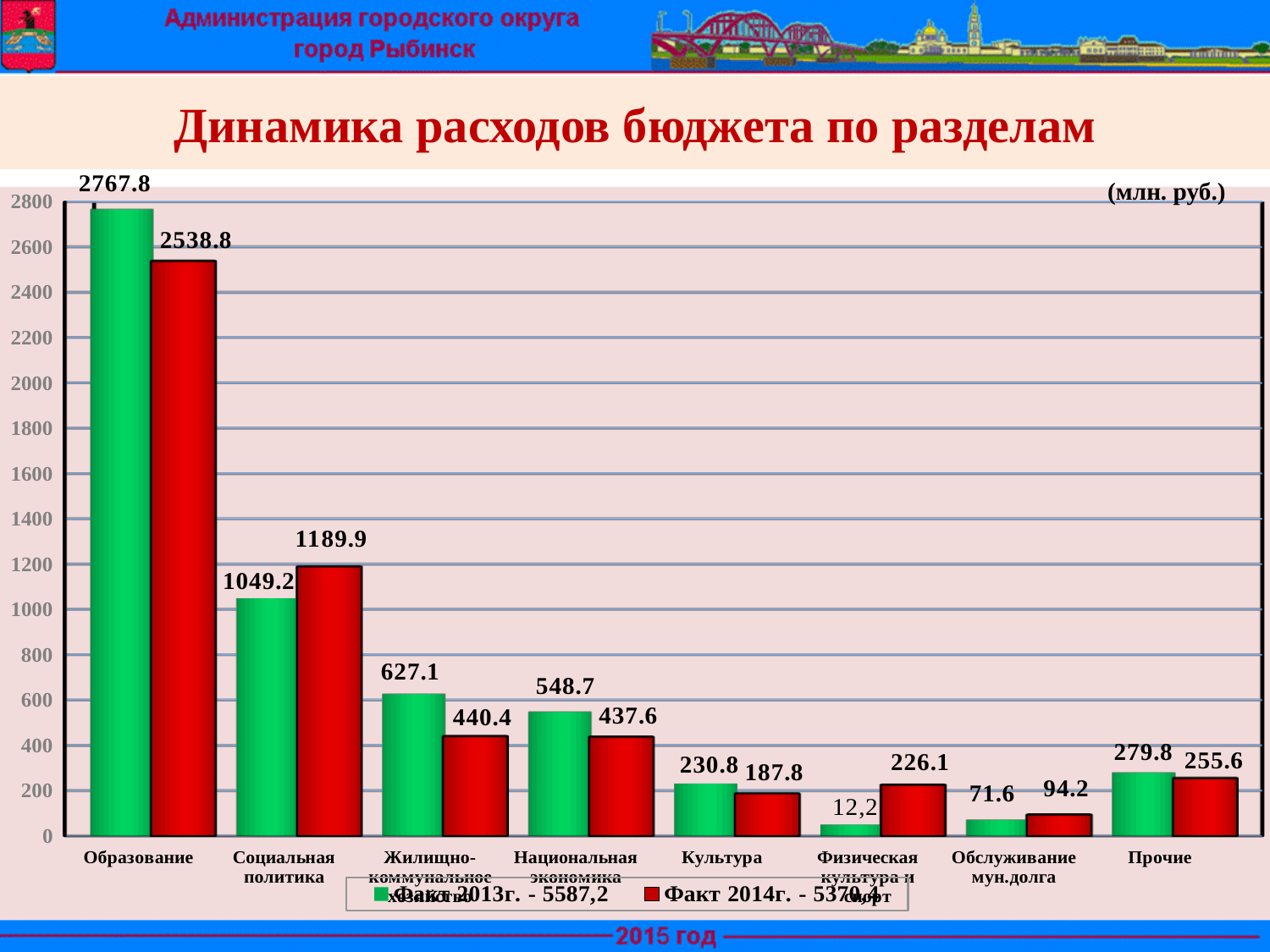
What kind of chart is shown on the slide? Bar chart What is the value for Социальная политика in the Факт 2014г. series? 1189.9 What is the value for Культура in the Факт 2014г. series? 187.8 What is the difference between the Факт 2013г. and Факт 2014г. values for Образование? 229.0 What unit is indicated in the top right corner of the chart? млн. руб. Which is larger for Социальная политика: the Факт 2013г. value or the Факт 2014г. value? Факт 2014г. How many series does the legend list? 2 How many categories are shown on the x axis? 8 Which category has the lowest value in the Факт 2013г. series? Физическая культура и спорт What is the value for Образование in the Факт 2013г. series? 2767.8 What is the value for Обслуживание мун.долга in the Факт 2013г. series? 71.6 Which category has the highest value in the Факт 2014г. series? Образование